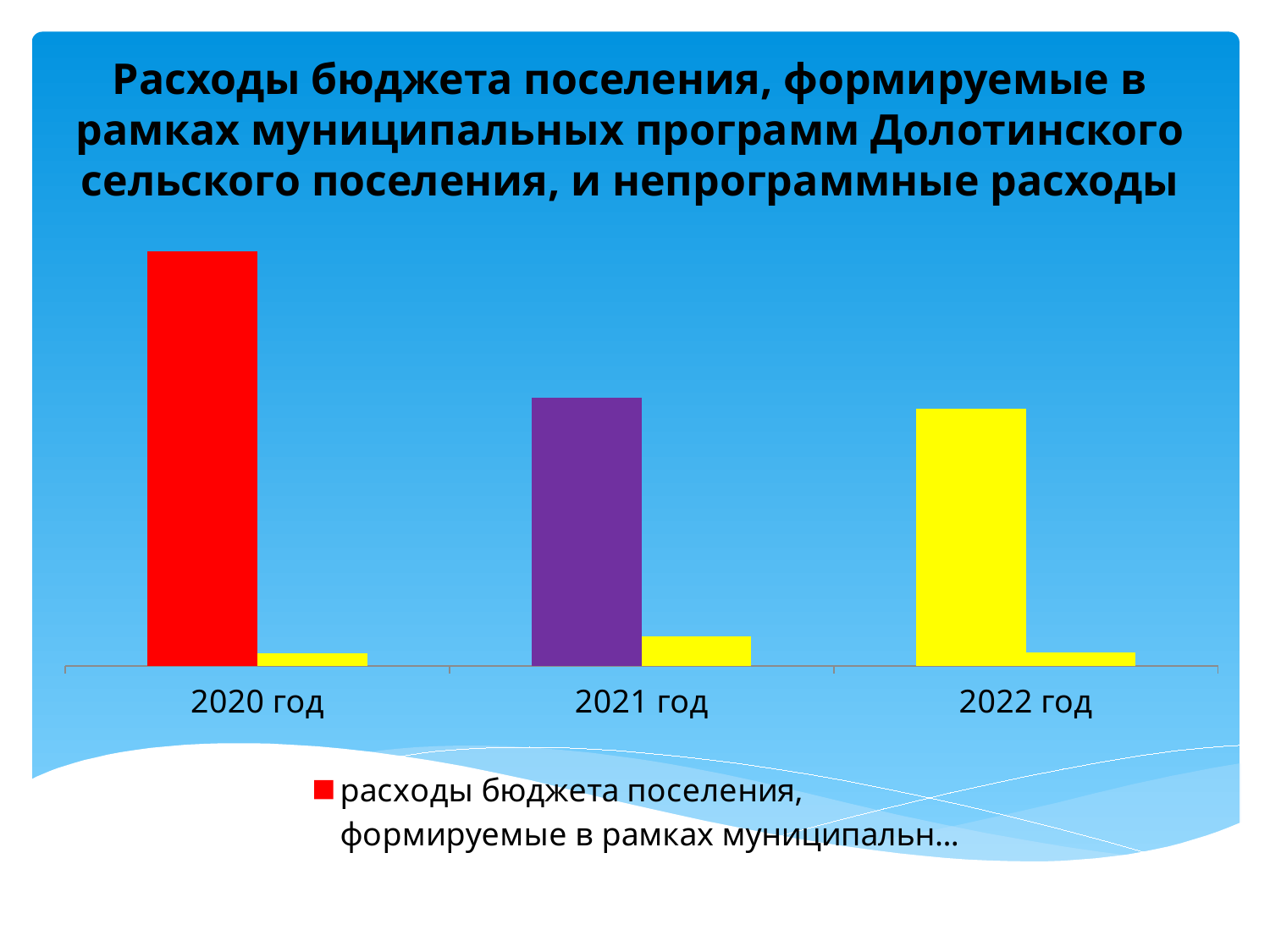
Do the first bars rise or fall from 2020 год to 2022 год? fall Is the first bar for 2020 год taller or shorter than the first bar for 2021 год? taller What colour is the tall bar for 2020 год? red Which year has the lowest tall (first) bar? 2022 год What kind of chart is shown on the slide? bar chart Which year has the tallest bar on the chart? 2020 год Is the first bar for 2021 год taller or shorter than the first bar for 2022 год? taller Which year has the tallest second (small) bar? 2021 год What is the label of the first category on the x axis? 2020 год How many year categories are shown on the x axis? 3